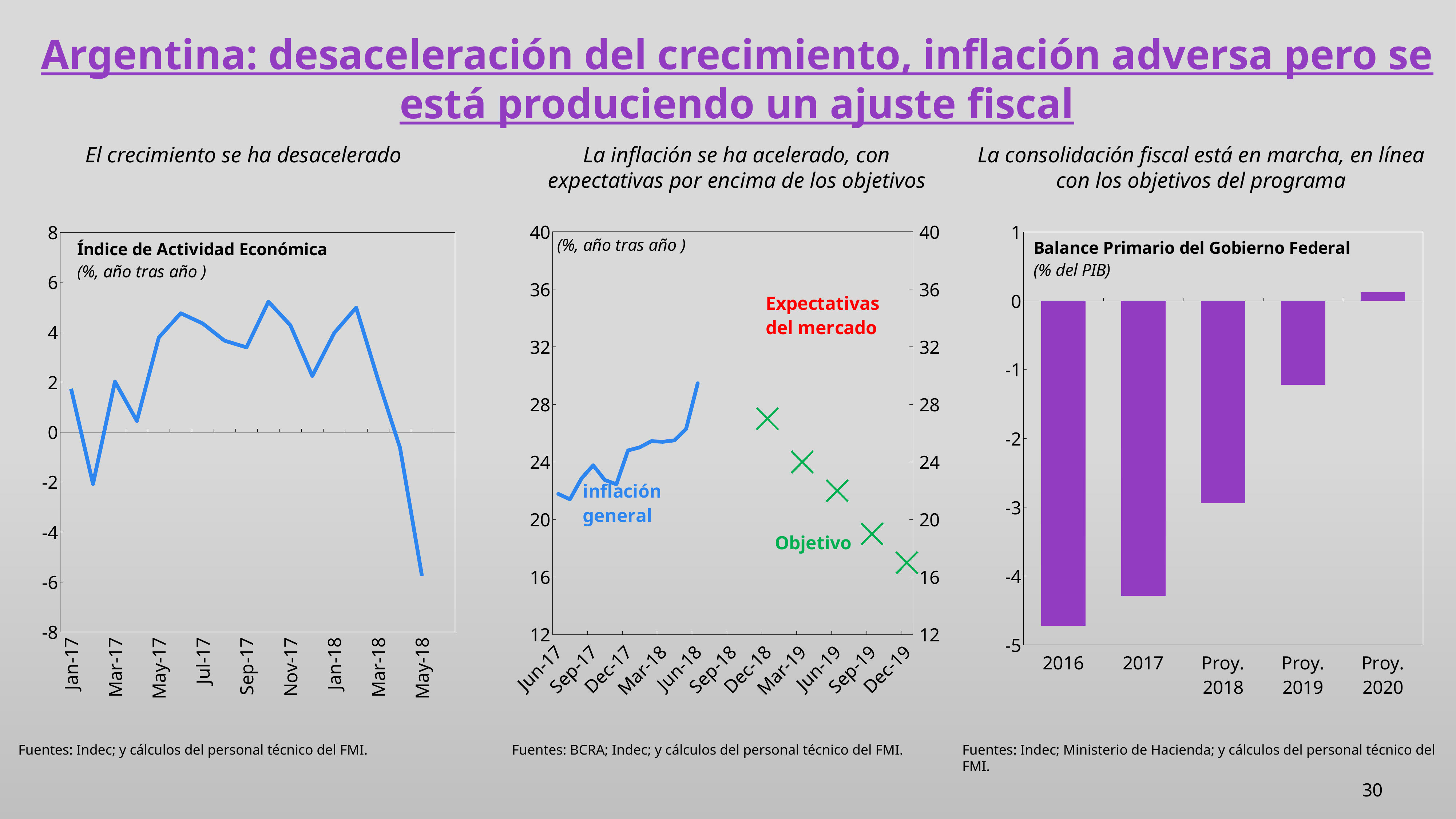
In the middle inflation chart, do the 'Objetivo' markers rise or fall from Dec-18 to Dec-19? fall In the 'Balance Primario del Gobierno Federal' chart, which category has the lowest value? 2016 In the 'Balance Primario del Gobierno Federal' chart, is the value for Proy. 2019 greater or less than -2? greater In the 'Índice de Actividad Económica' chart, is the value for May-18 greater or less than -4? less What kind of chart is the 'Balance Primario del Gobierno Federal' chart on the right? bar chart In the 'Balance Primario del Gobierno Federal' chart, do the values rise or fall from 2016 to Proy. 2020? rise In the 'Balance Primario del Gobierno Federal' chart, how many bars are plotted? 5 In the middle inflation chart, is the 'inflación general' value for Jun-18 greater or less than 28? greater What kind of chart is the 'Índice de Actividad Económica' chart on the left? line chart In the 'Balance Primario del Gobierno Federal' chart, which category has the highest value? Proy. 2020 In the 'Índice de Actividad Económica' chart, which month has the lowest value? May-18